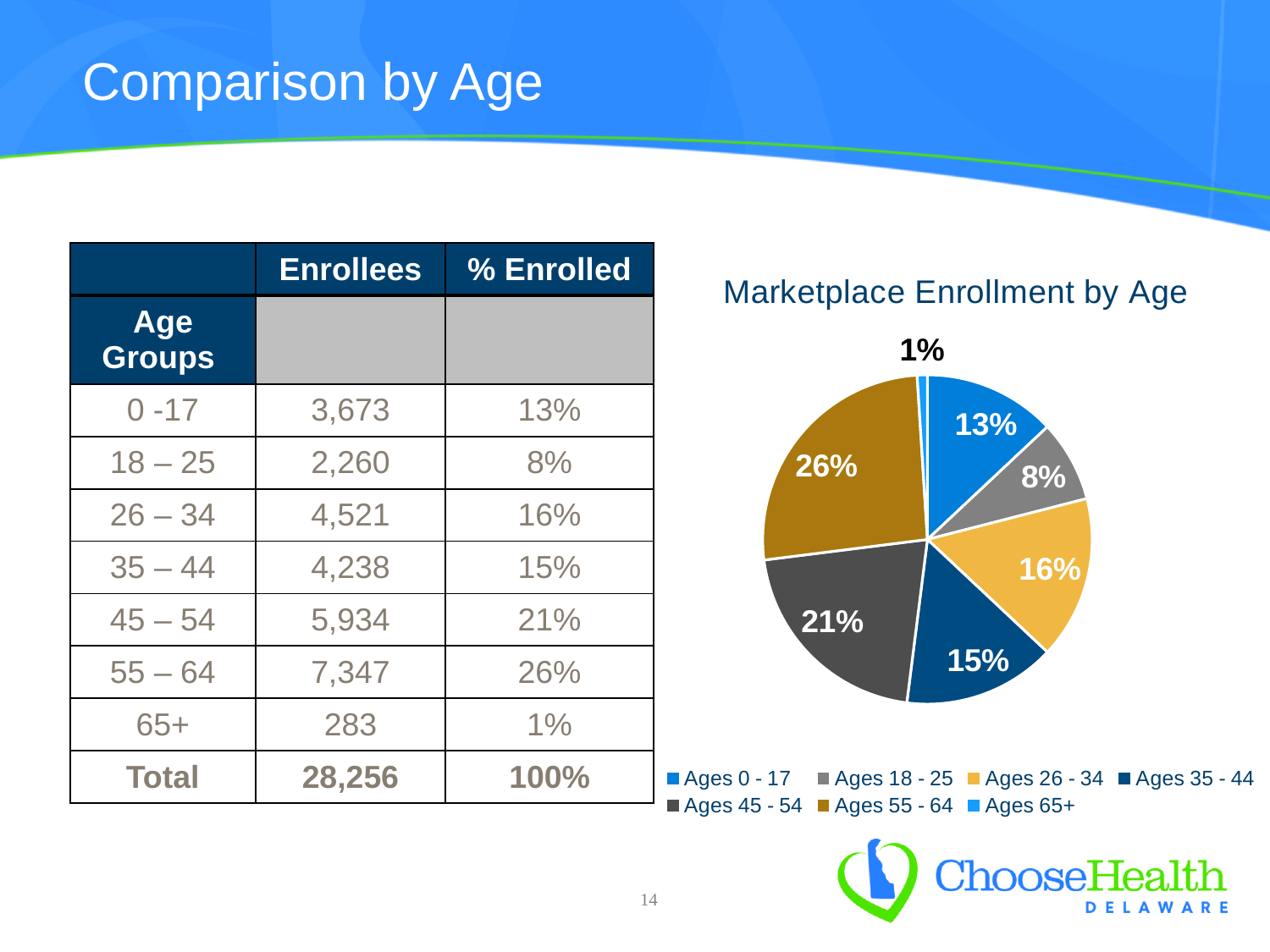
What share of the pie does Ages 0 - 17 have? 13% What share of the pie does Ages 45 - 54 have? 21% Which age group has the smallest slice of the pie? Ages 65+ How many slices does the pie chart have? 7 Which age group has the largest slice of the pie? Ages 55 - 64 What share of the pie does Ages 65+ have? 1% What is the title of the pie chart? Marketplace Enrollment by Age Which slice is larger, Ages 26 - 34 or Ages 35 - 44? Ages 26 - 34 What is the difference in percentage points between the Ages 45 - 54 slice and the Ages 18 - 25 slice? 13 How many entries does the pie chart legend list? 7 What kind of chart is "Marketplace Enrollment by Age"? pie chart